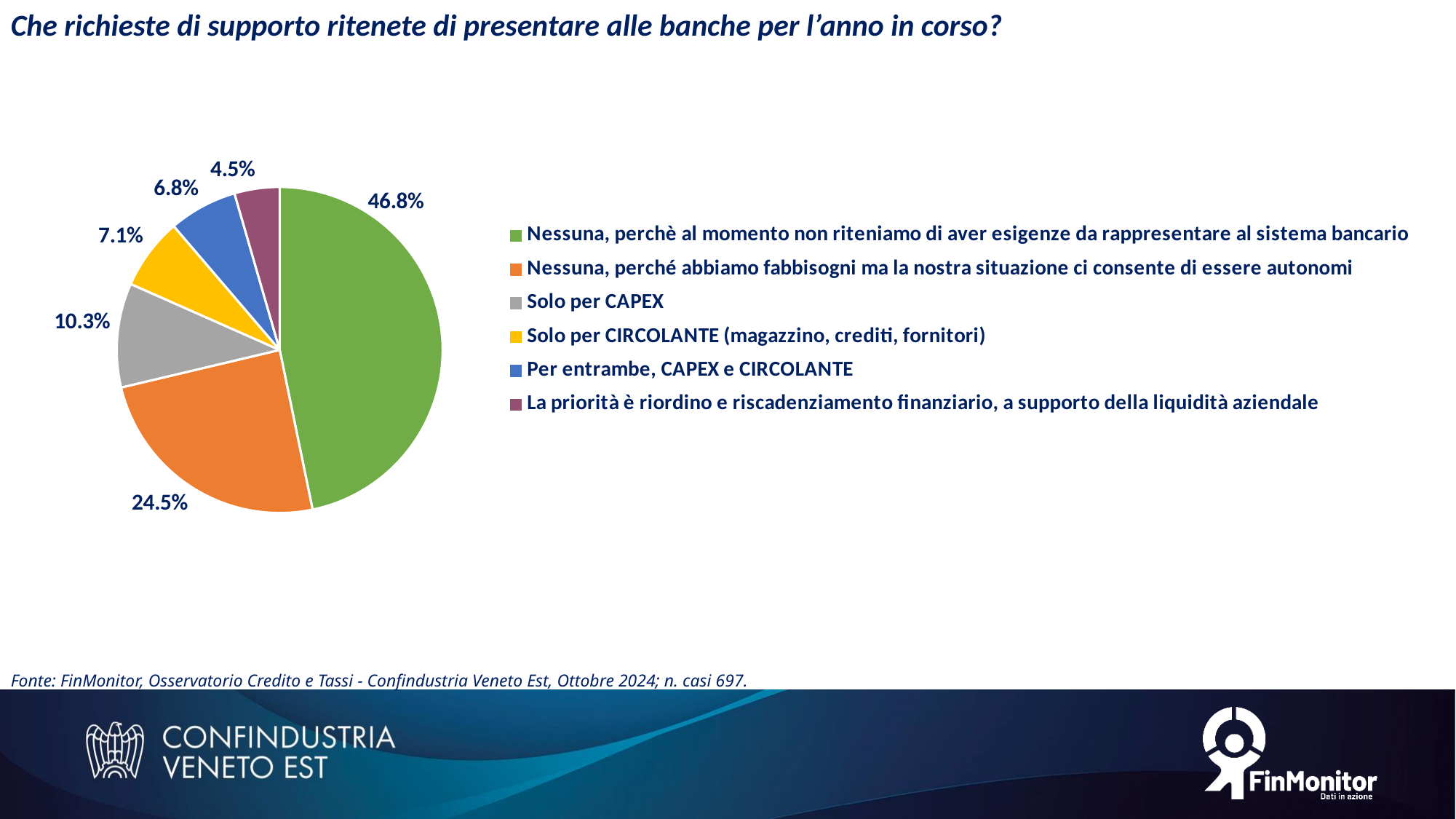
What kind of chart is shown on the slide? Pie chart What share of the pie is 'Solo per CIRCOLANTE (magazzino, crediti, fornitori)'? 7.1% What share of the pie is 'Per entrambe, CAPEX e CIRCOLANTE'? 6.8% What share of the pie is 'La priorità è riordino e riscadenziamento finanziario, a supporto della liquidità aziendale'? 4.5% What colour is the slice for 'Solo per CAPEX'? Grey Which category has the smallest slice of the pie? La priorità è riordino e riscadenziamento finanziario, a supporto della liquidità aziendale Which category has the largest slice of the pie? Nessuna, perchè al momento non riteniamo di aver esigenze da rappresentare al sistema bancario Which is larger: the share for 'Solo per CAPEX' or the share for 'Solo per CIRCOLANTE (magazzino, crediti, fornitori)'? Solo per CAPEX How many categories does the pie chart have? 6 What is the difference in percentage points between the 'Nessuna, perchè al momento non riteniamo di aver esigenze...' slice (46.8%) and the 'Nessuna, perché abbiamo fabbisogni...' slice (24.5%)? 22.3 percentage points What share of the pie is 'Solo per CAPEX'? 10.3% What share of the pie is 'Nessuna, perché abbiamo fabbisogni ma la nostra situazione ci consente di essere autonomi'? 24.5%